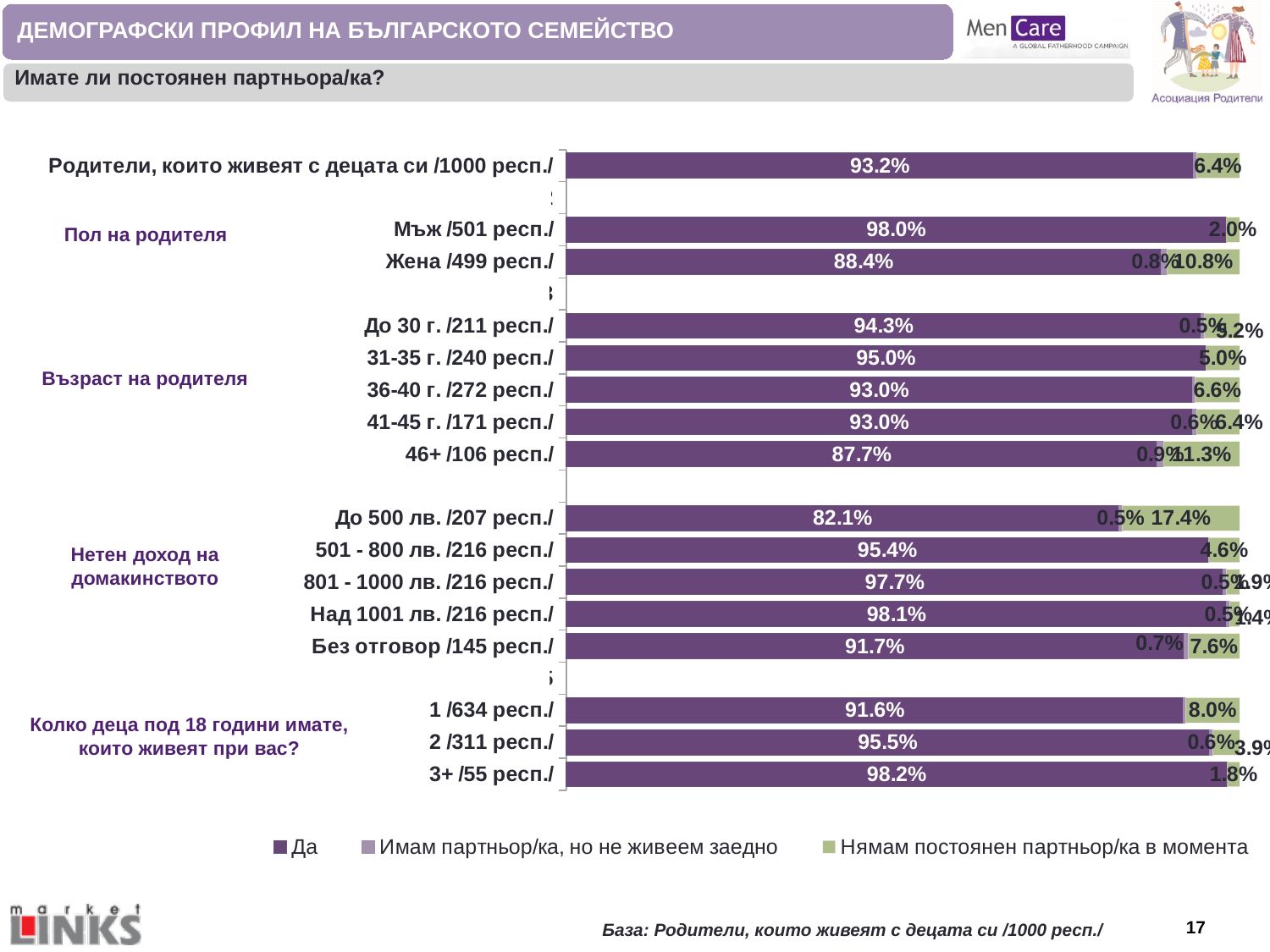
What kind of chart is shown on the slide? bar chart What is the "Да" value for "Мъж /501 респ./"? 98.0% What is the difference between the "Да" values for "Мъж /501 респ./" and "Жена /499 респ./"? 9.6 percentage points Which category has the lowest "Да" value? До 500 лв. /207 респ./ What is the "Да" value for "Жена /499 респ./"? 88.4% How many series does the legend list? 3 What is the "Да" value for "46+ /106 респ./"? 87.7% Which category has the highest "Да" value? 3+ /55 респ./ What is the "Нямам постоянен партньор/ка в момента" value for "До 500 лв. /207 респ./"? 17.4% Which has a larger "Да" value, "31-35 г. /240 респ./" or "46+ /106 респ./"? 31-35 г. /240 респ./ What is the "Имам партньор/ка, но не живеем заедно" value for "Без отговор /145 респ./"? 0.7% What is the "Нямам постоянен партньор/ка в момента" value for "1 /634 респ./"? 8.0%